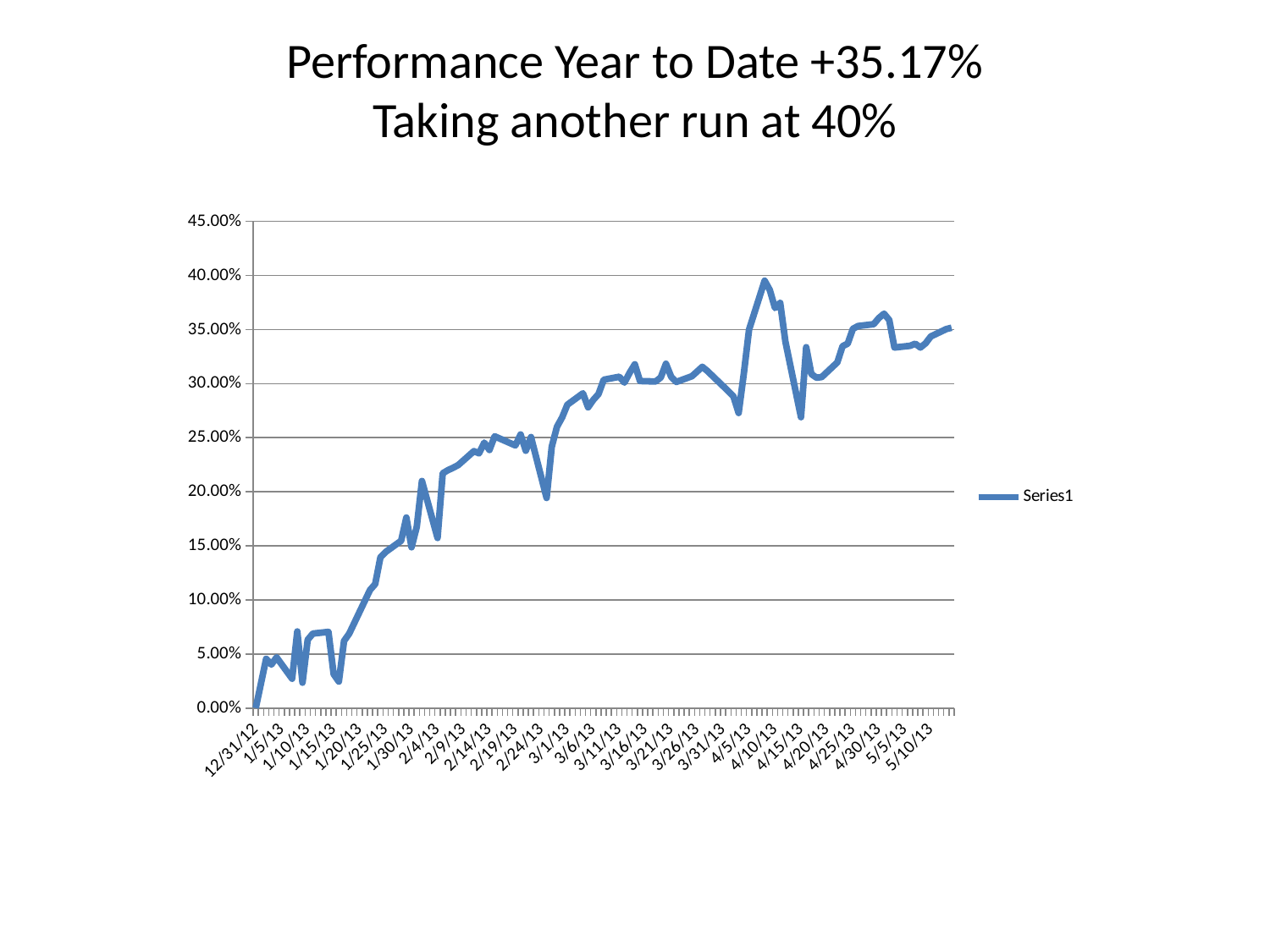
What is the title of the chart on the slide? Performance Year to Date +35.17% Taking another run at 40% Which is larger, the value at 1/5/13 or the value at 4/20/13? 4/20/13 What is the name of the series shown in the legend? Series1 What kind of chart is shown on the slide? line chart Is the value for 3/16/13 greater or less than 25.00%? greater Is the value for 5/10/13 greater or less than 30.00%? greater What is the highest value shown on the y axis? 45.00% What is the value of Series1 at 12/31/12? 0.00% Overall, does the line rise or fall from 12/31/12 to 5/10/13? rise Is the value for 2/19/13 greater or less than 20.00%? greater How many series does the legend list? 1